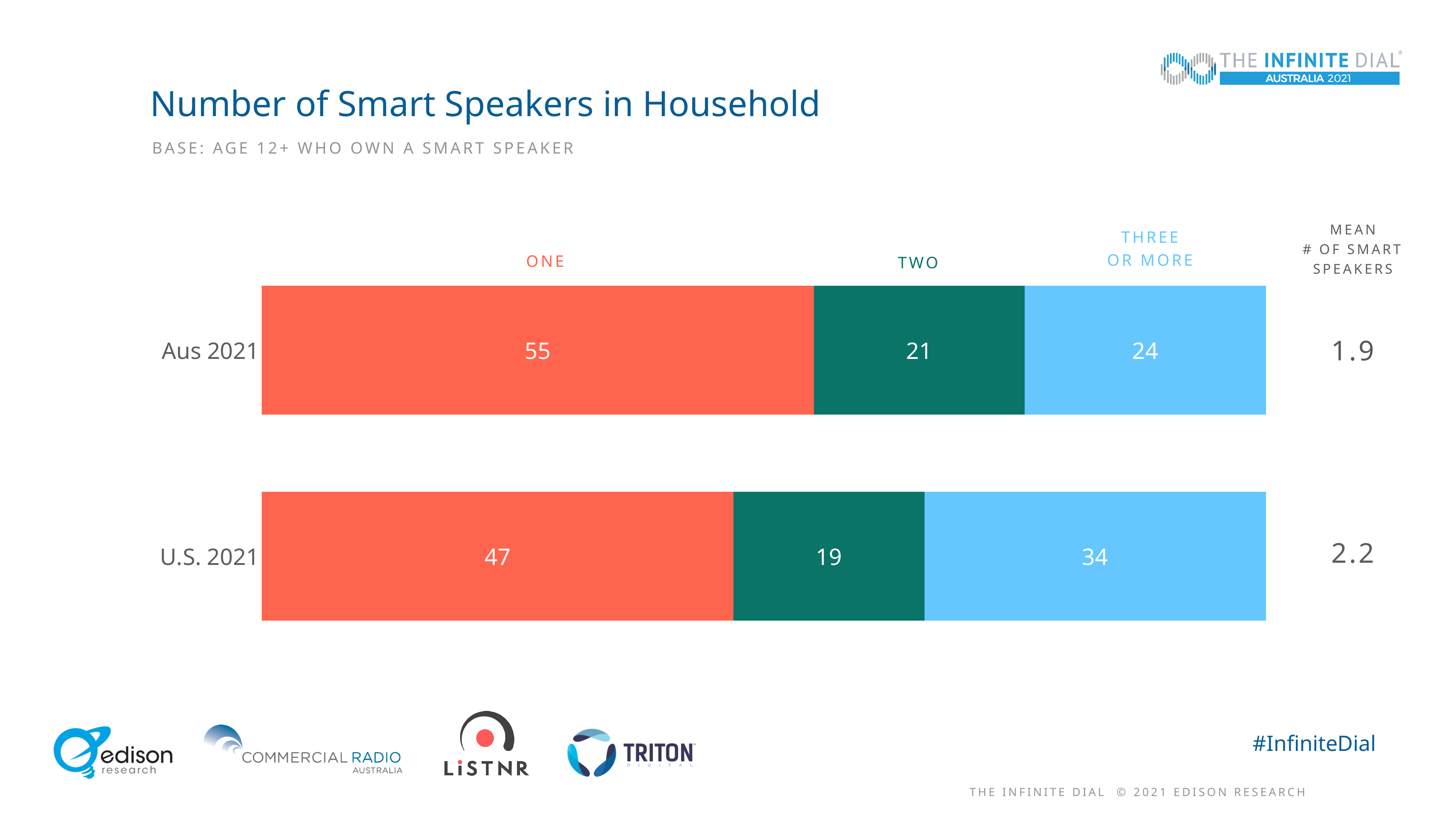
What is the mean number of smart speakers for U.S. 2021? 2.2 What is the total of the U.S. 2021 bar? 100 What is the difference between the 'Three or more' values for U.S. 2021 and Aus 2021? 10 What is the value for 'Three or more' smart speakers for U.S. 2021? 34 Which is larger: the 'One' value for Aus 2021 or for U.S. 2021? Aus 2021 What kind of chart is shown on the slide? Stacked bar chart What is the value for 'One' smart speaker for Aus 2021? 55 How many series (segments) does each bar contain? 3 How many bars (categories) are shown in the chart? 2 What is the value for 'Two' smart speakers for Aus 2021? 21 Which segment is the smallest in the U.S. 2021 bar? Two Which segment is the largest in the Aus 2021 bar? One